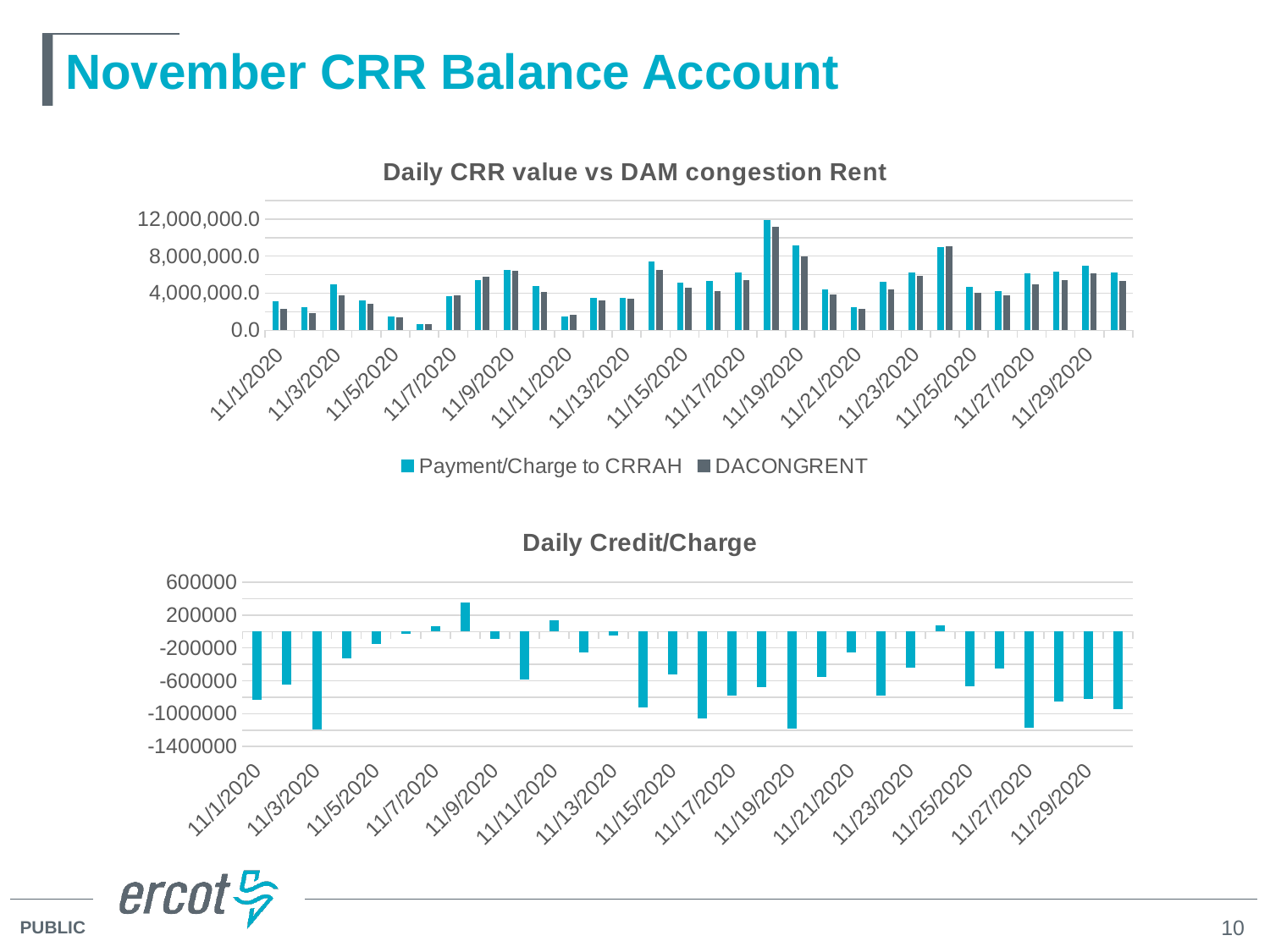
In the 'Daily CRR value vs DAM congestion Rent' chart, is the Payment/Charge to CRRAH value for 11/5/2020 greater or less than 4,000,000.0? less In the 'Daily Credit/Charge' chart, on which date is the value highest? 11/8/2020 In the 'Daily CRR value vs DAM congestion Rent' chart, which is larger on 11/19/2020: Payment/Charge to CRRAH or DACONGRENT? Payment/Charge to CRRAH In the 'Daily CRR value vs DAM congestion Rent' chart, on which date is the Payment/Charge to CRRAH value highest? 11/18/2020 What are the two legend entries of the 'Daily CRR value vs DAM congestion Rent' chart? Payment/Charge to CRRAH and DACONGRENT In the 'Daily Credit/Charge' chart, is the value for 11/9/2020 greater or less than 200000? less What kind of chart is the 'Daily Credit/Charge' chart? bar chart In the 'Daily Credit/Charge' chart, is the value for 11/3/2020 greater or less than -1000000? less How many series does the legend of the 'Daily CRR value vs DAM congestion Rent' chart list? 2 In the 'Daily CRR value vs DAM congestion Rent' chart, is the Payment/Charge to CRRAH value larger on 11/19/2020 or on 11/5/2020? 11/19/2020 What kind of chart is the 'Daily CRR value vs DAM congestion Rent' chart? bar chart